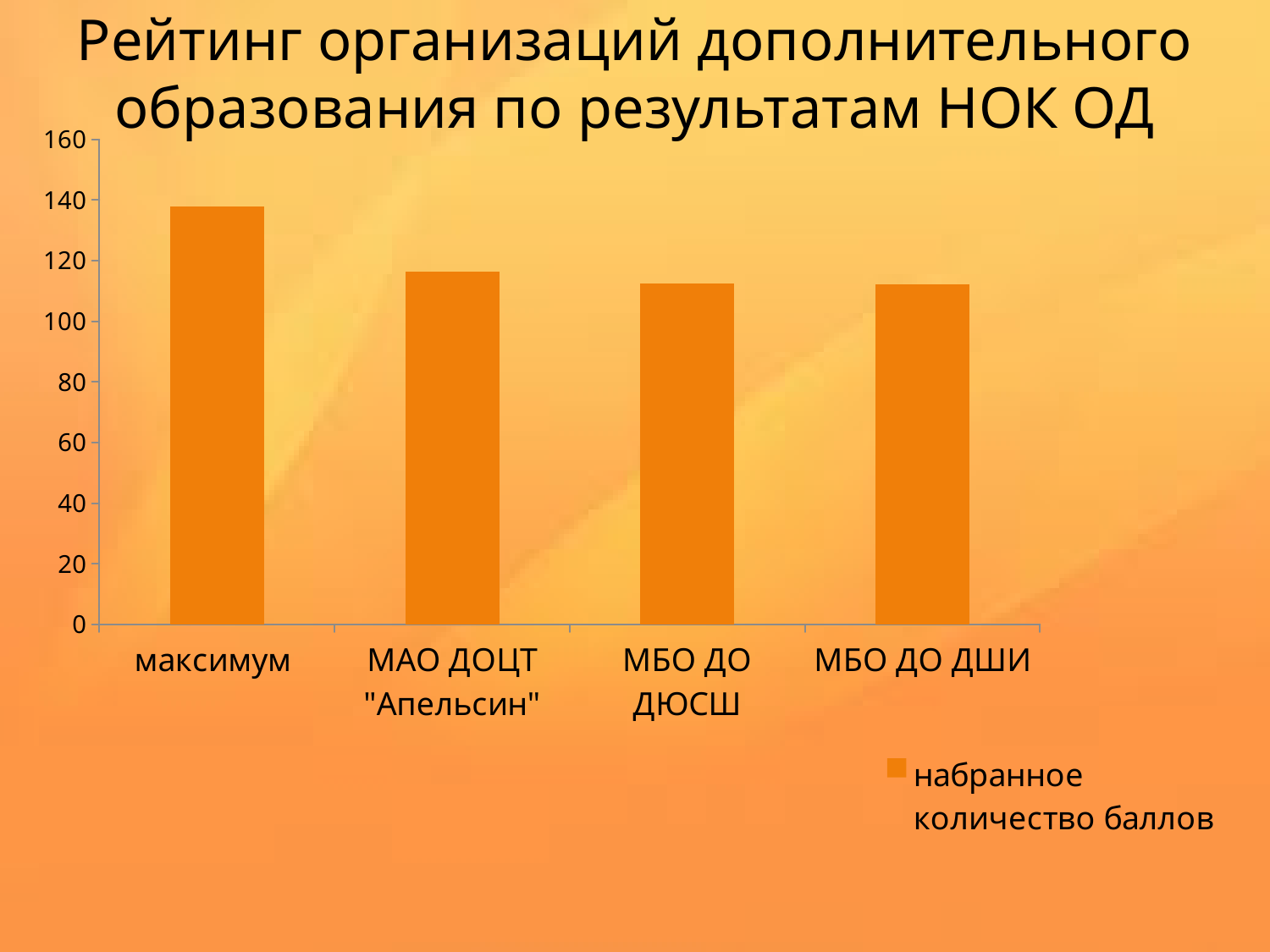
Which category has the highest bar in the chart? максимум What kind of chart is shown on the slide? bar chart Is the value for максимум greater or less than 120? greater How many categories are shown on the x axis of the chart? 4 Is the value for МАО ДОЦТ "Апельсин" greater or less than 100? greater How many series does the chart legend list? 1 Which is larger, the value for максимум or the value for МБО ДО ДШИ? максимум Which is larger, the value for максимум or the value for МАО ДОЦТ "Апельсин"? максимум What is the name of the series shown in the chart legend? набранное количество баллов What is the title of the slide containing the chart? Рейтинг организаций дополнительного образования по результатам НОК ОД Is the value for МБО ДО ДШИ greater or less than 100? greater